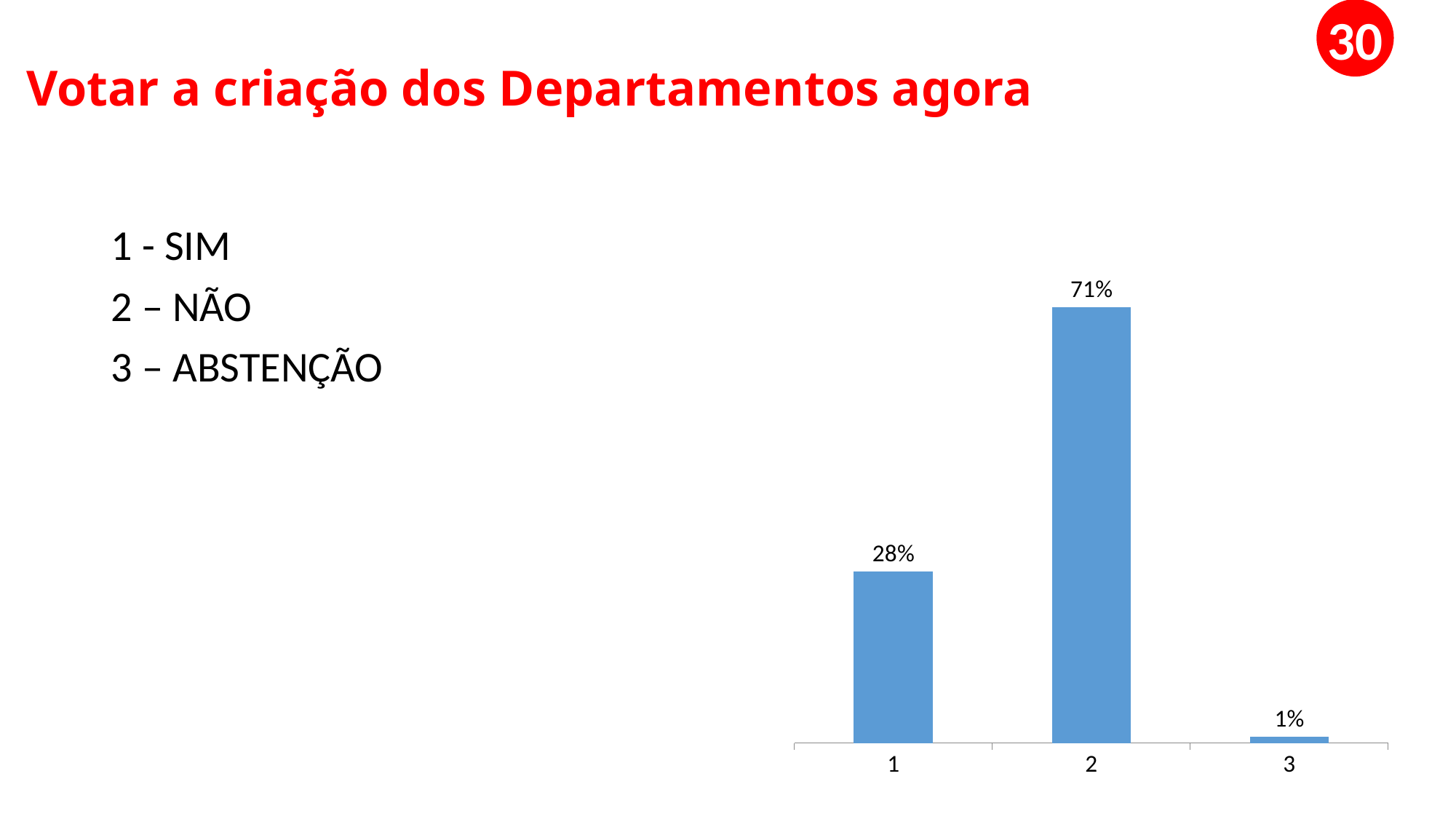
What kind of chart is shown on the slide? bar chart How many categories are shown on the x axis? 3 According to the slide's key, what does category 2 stand for? NÃO Which category has the highest value? 2 What is the value for category 3? 1% Which is larger, the value for category 1 or the value for category 3? 1 What is the value for category 1? 28% What is the value for category 2? 71% What is the difference between the values for category 2 and category 1? 43% What is the difference between the values for category 1 and category 3? 27% Which category has the lowest value? 3 What colour are the bars in the chart? blue